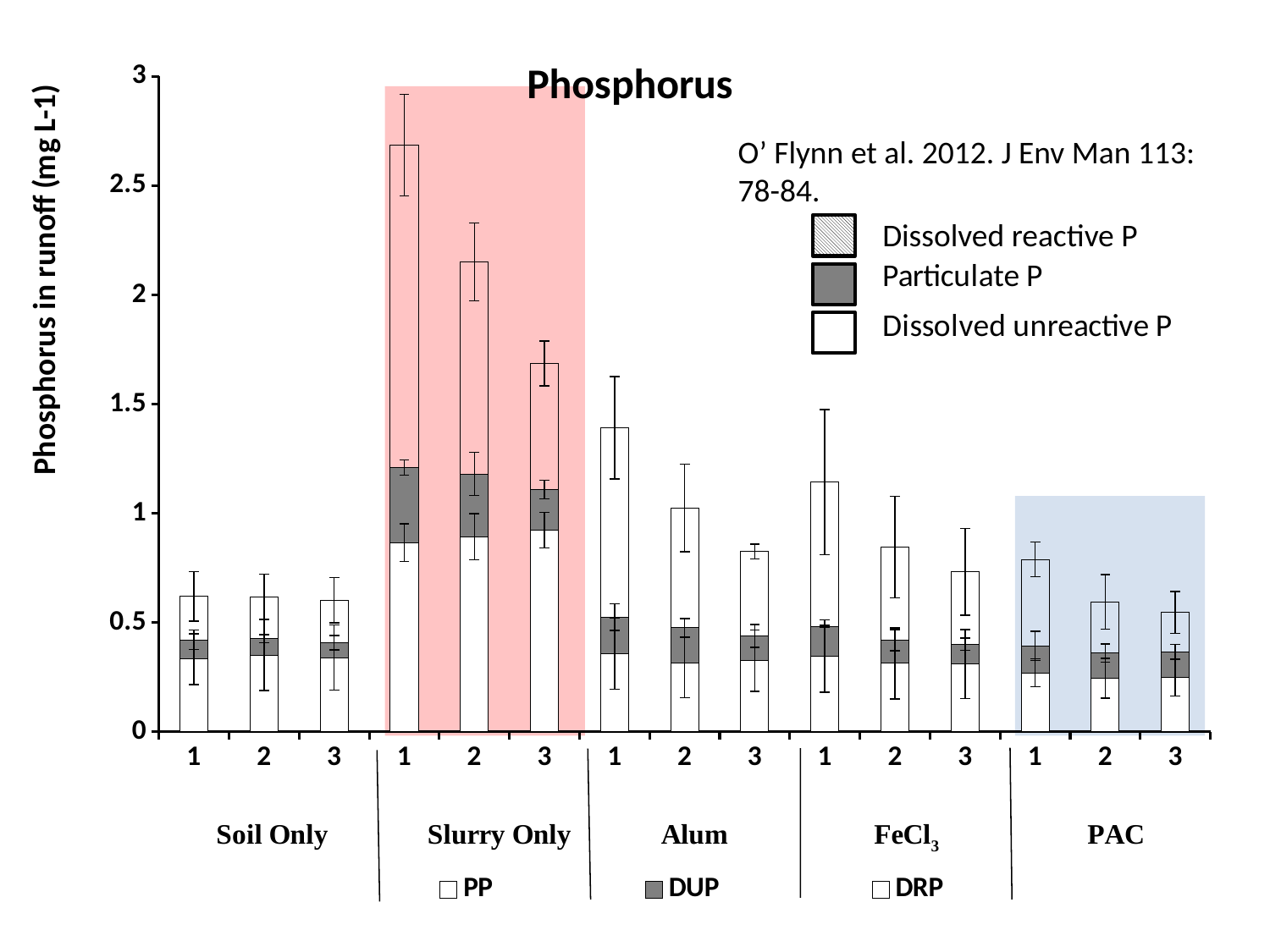
Is the total value for Slurry Only bar 3 greater or less than 1.5? greater How many series does the legend below the x axis list? 3 How many bars are plotted in total on the chart? 15 Within the Slurry Only group, do the total bar heights rise or fall from bar 1 to bar 3? fall Is the total value for Slurry Only bar 1 greater or less than 2.5? greater Which bar has the highest total phosphorus in runoff? Slurry Only, bar 1 Is the total value for Alum bar 1 greater or less than 1.5? less Which has the larger total phosphorus in runoff: Slurry Only bar 1 or Alum bar 1? Slurry Only bar 1 How many treatment groups are shown along the x axis? 5 What kind of chart is shown on the slide? Stacked bar chart What is the title of the chart? Phosphorus